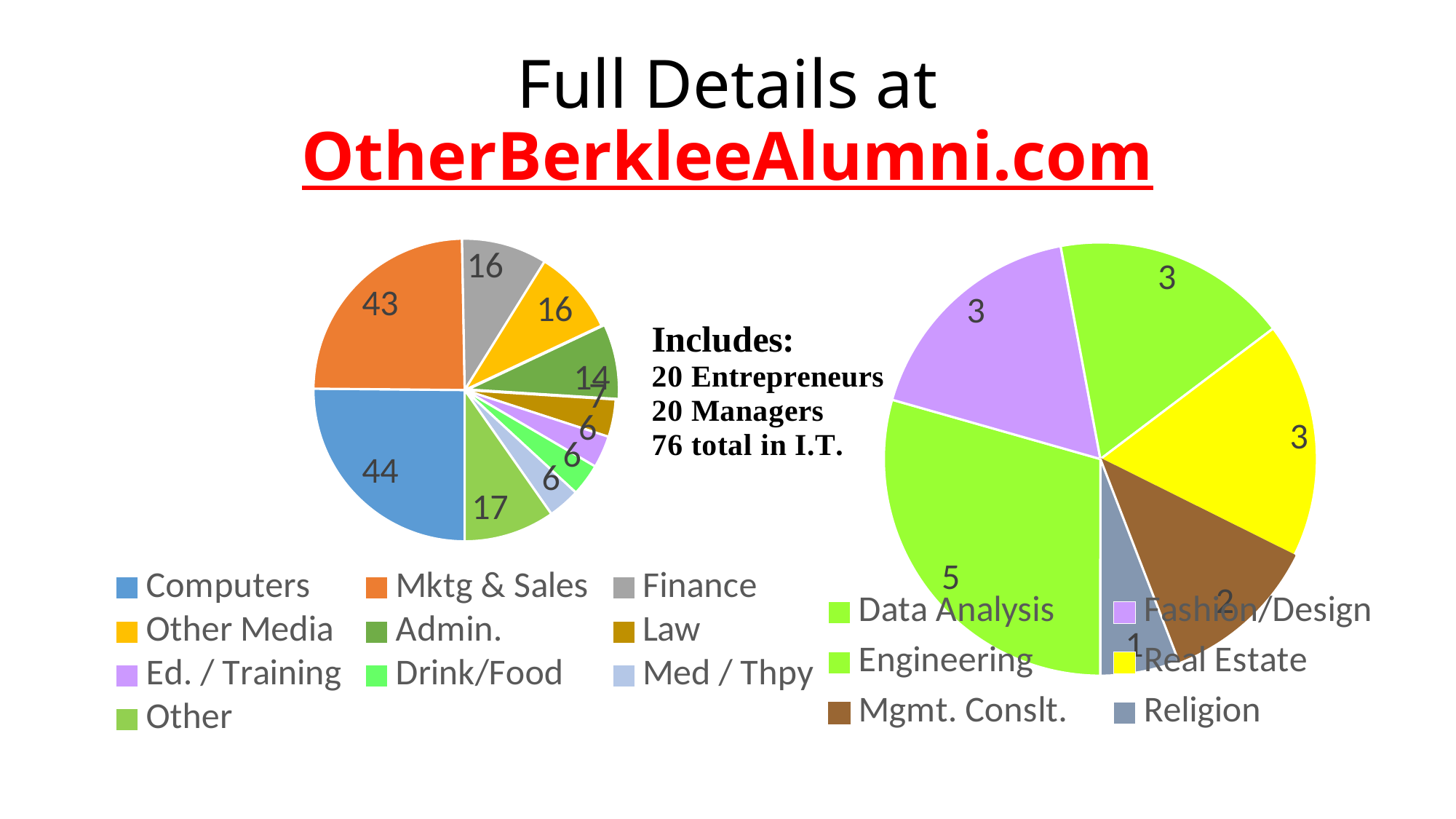
On the left pie chart, what is the value for Admin.? 14 On the left pie chart, which is larger, Finance or Admin.? Finance On the right pie chart, what is the value for Mgmt. Conslt.? 2 On the left pie chart, what is the difference between Computers and Mktg & Sales? 1 On the right pie chart, which category has the lowest value? Religion What kind of chart is the right chart? Pie chart On the left pie chart, what is the value for Law? 7 On the right pie chart, what is the value for Real Estate? 3 On the left pie chart, what is the value for Mktg & Sales? 43 How many categories does the left pie chart's legend list? 10 On the left pie chart, what is the value for Computers? 44 On the left pie chart, which category has the highest value? Computers